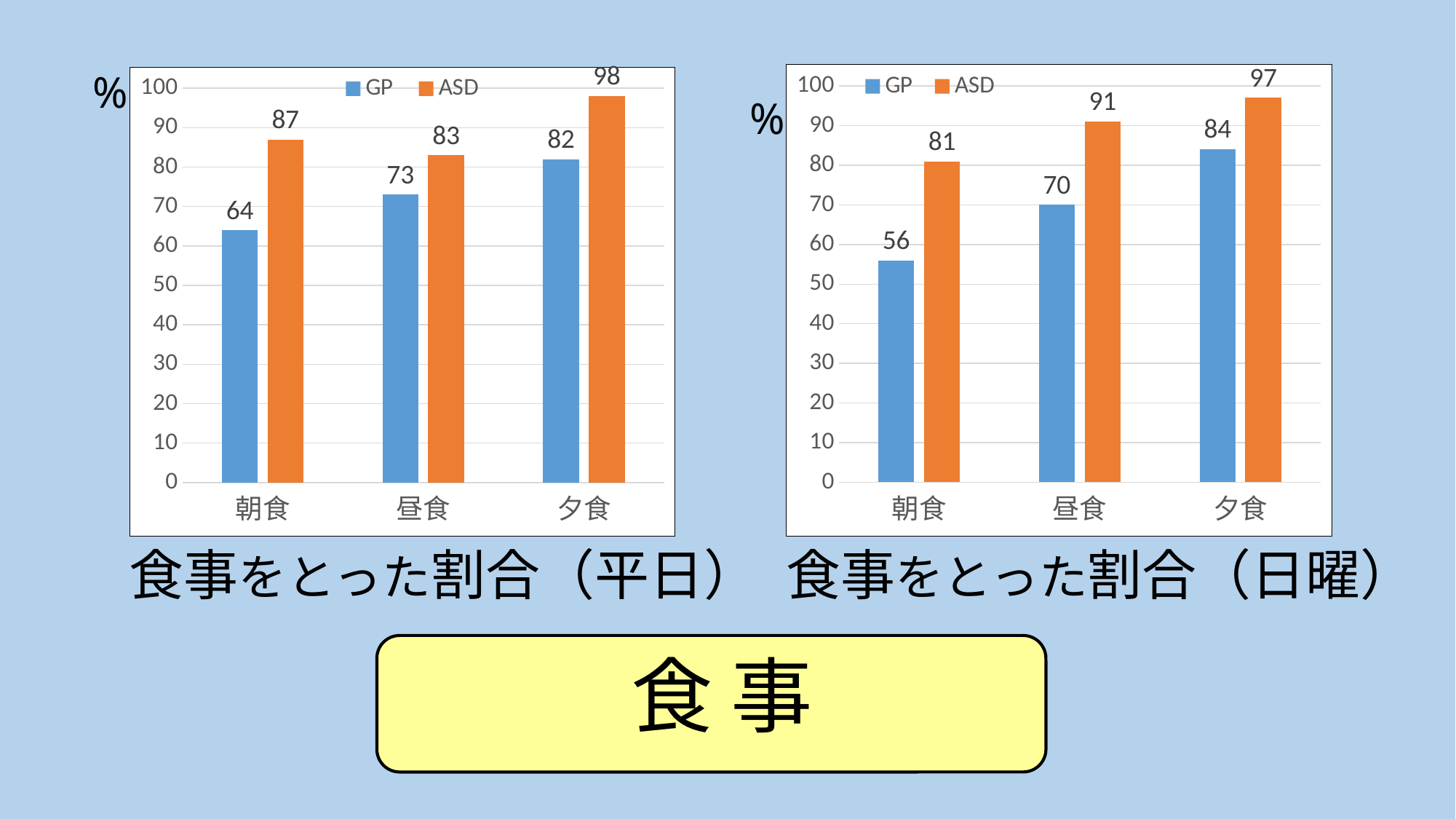
In the left chart (食事をとった割合（平日）), what is the GP value for 朝食? 64 How many series does the legend of the right chart (食事をとった割合（日曜）) list? 2 In the right chart (食事をとった割合（日曜）), which category has the highest ASD value? 夕食 In the right chart (食事をとった割合（日曜）), what is the difference between the ASD and GP values for 昼食? 21 What kind of chart is the left chart (食事をとった割合（平日）)? Bar chart In the right chart (食事をとった割合（日曜）), which is larger for 夕食, GP or ASD? ASD In the right chart (食事をとった割合（日曜）), what is the GP value for 昼食? 70 In the left chart (食事をとった割合（平日）), what is the difference between the ASD and GP values for 朝食? 23 How many categories are shown on the x axis of the left chart (食事をとった割合（平日）)? 3 In the left chart (食事をとった割合（平日）), what is the ASD value for 夕食? 98 In the right chart (食事をとった割合（日曜）), what is the ASD value for 朝食? 81 In the left chart (食事をとった割合（平日）), which category has the lowest GP value? 朝食